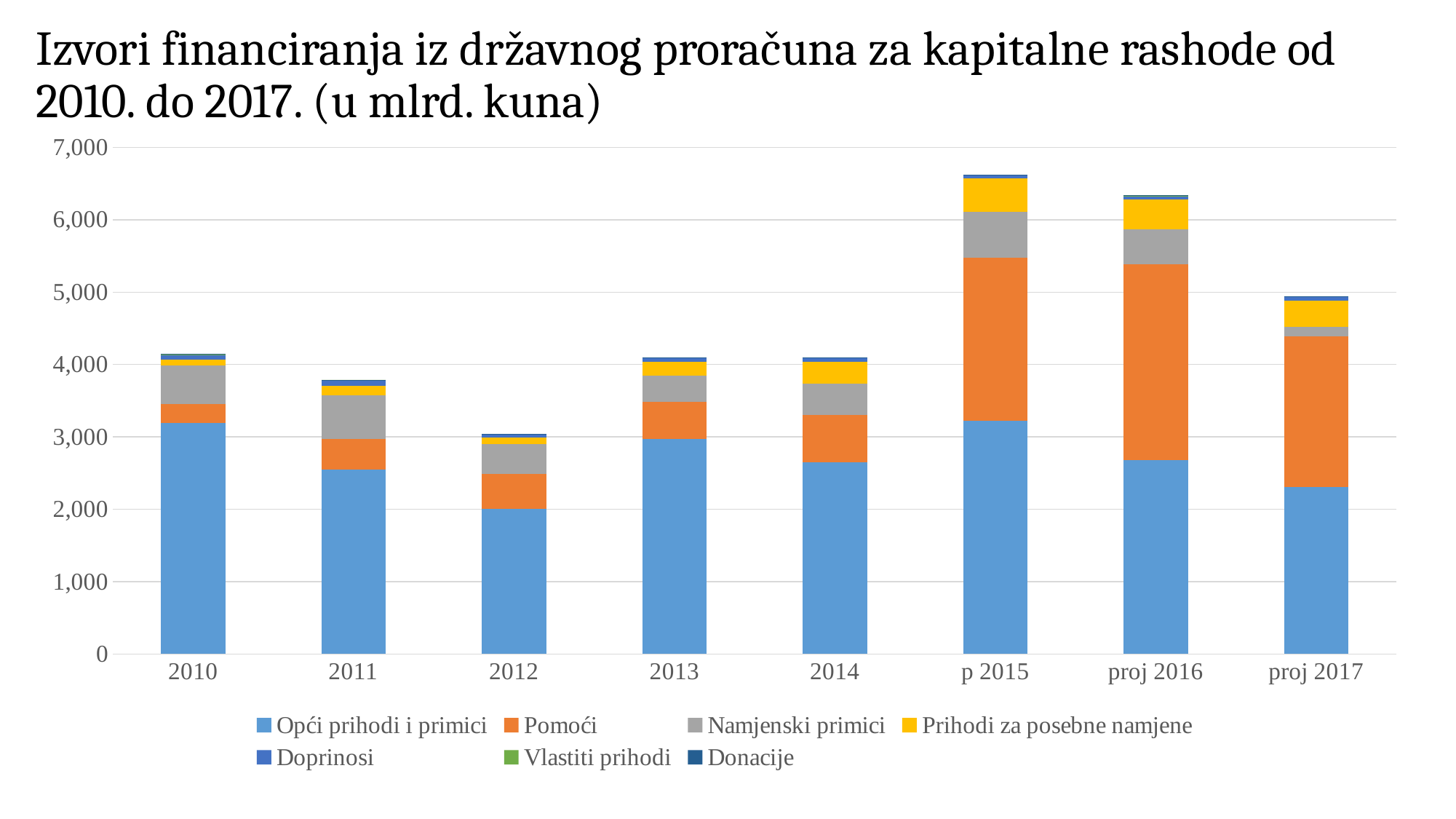
Which year has the highest total stacked bar? p 2015 Which has the larger total, p 2015 or proj 2016? p 2015 How many years (categories) are shown on the x axis? 8 Is the Opći prihodi i primici segment larger in 2010 or in 2012? 2010 Do the total bars rise or fall from 2010 to 2012? fall What kind of chart is shown on the slide? Stacked bar chart Is the total for p 2015 greater or less than 6,000? greater Which year has the lowest total stacked bar? 2012 Is the total for 2012 greater or less than 4,000? less What colour represents Pomoći in the legend? Orange How many series does the legend list? 7 Is the total for 2010 greater or less than 4,000? greater